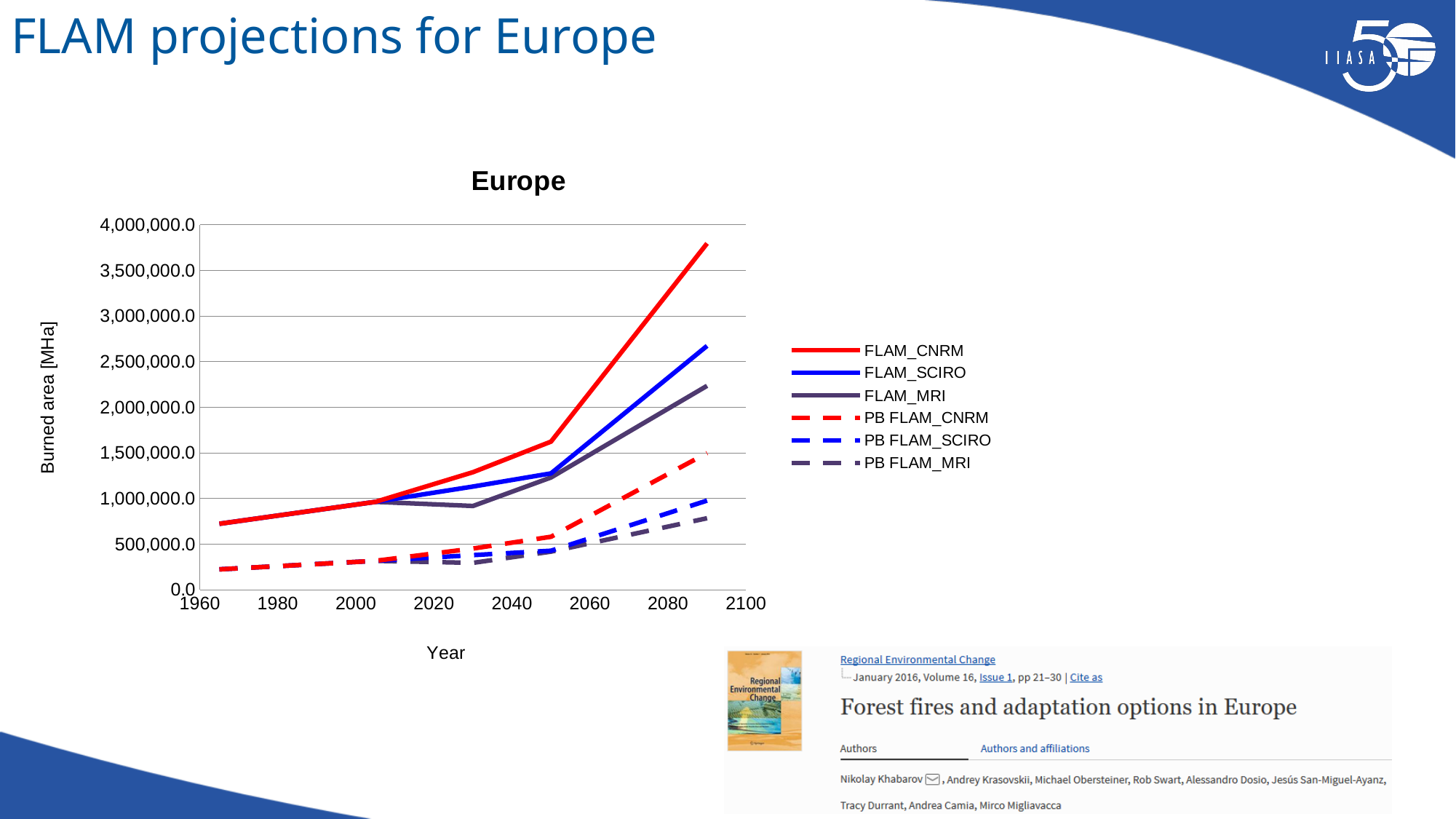
Is the value for FLAM_CNRM at its last point (around 2090) greater or less than 3,500,000.0? greater At the right end of the chart (around 2090), which is larger: FLAM_SCIRO or PB FLAM_SCIRO? FLAM_SCIRO Is the value for PB FLAM_MRI at its last point (around 2090) greater or less than 500,000.0? greater Is the value for FLAM_MRI at its last point (around 2090) greater or less than 2,000,000.0? greater Which series has the lowest value at the right end of the chart (around 2090)? PB FLAM_MRI What is the title of the chart? Europe Does the FLAM_CNRM series rise or fall along the x axis? rise What is the label of the vertical axis? Burned area [MHa] Which series has the highest value at the right end of the chart (around 2090)? FLAM_CNRM How many series does the legend list? 6 What kind of chart is shown on the slide? line chart